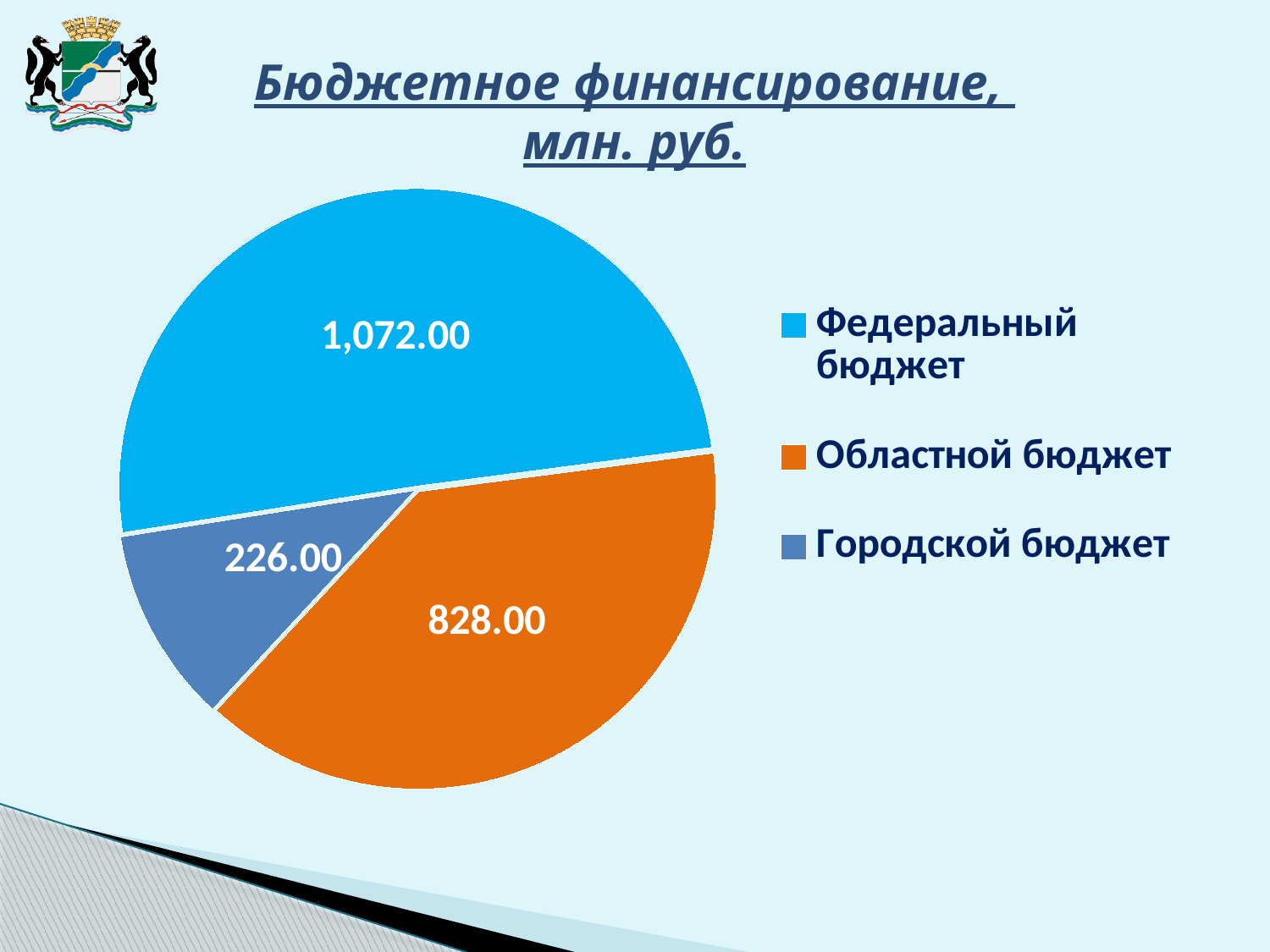
What is the title of the chart? Бюджетное финансирование, млн. руб. What is the difference between Областной бюджет and Городской бюджет? 602.00 What kind of chart is shown on the slide? Pie chart What is the value for Областной бюджет? 828.00 What is the value for Федеральный бюджет? 1,072.00 How many entries does the legend list? 3 What is the value for Городской бюджет? 226.00 Which is larger, Областной бюджет or Городской бюджет? Областной бюджет How many slices does the pie chart have? 3 What is the difference between Федеральный бюджет and Областной бюджет? 244.00 Which budget source has the largest slice? Федеральный бюджет Which budget source has the smallest slice? Городской бюджет